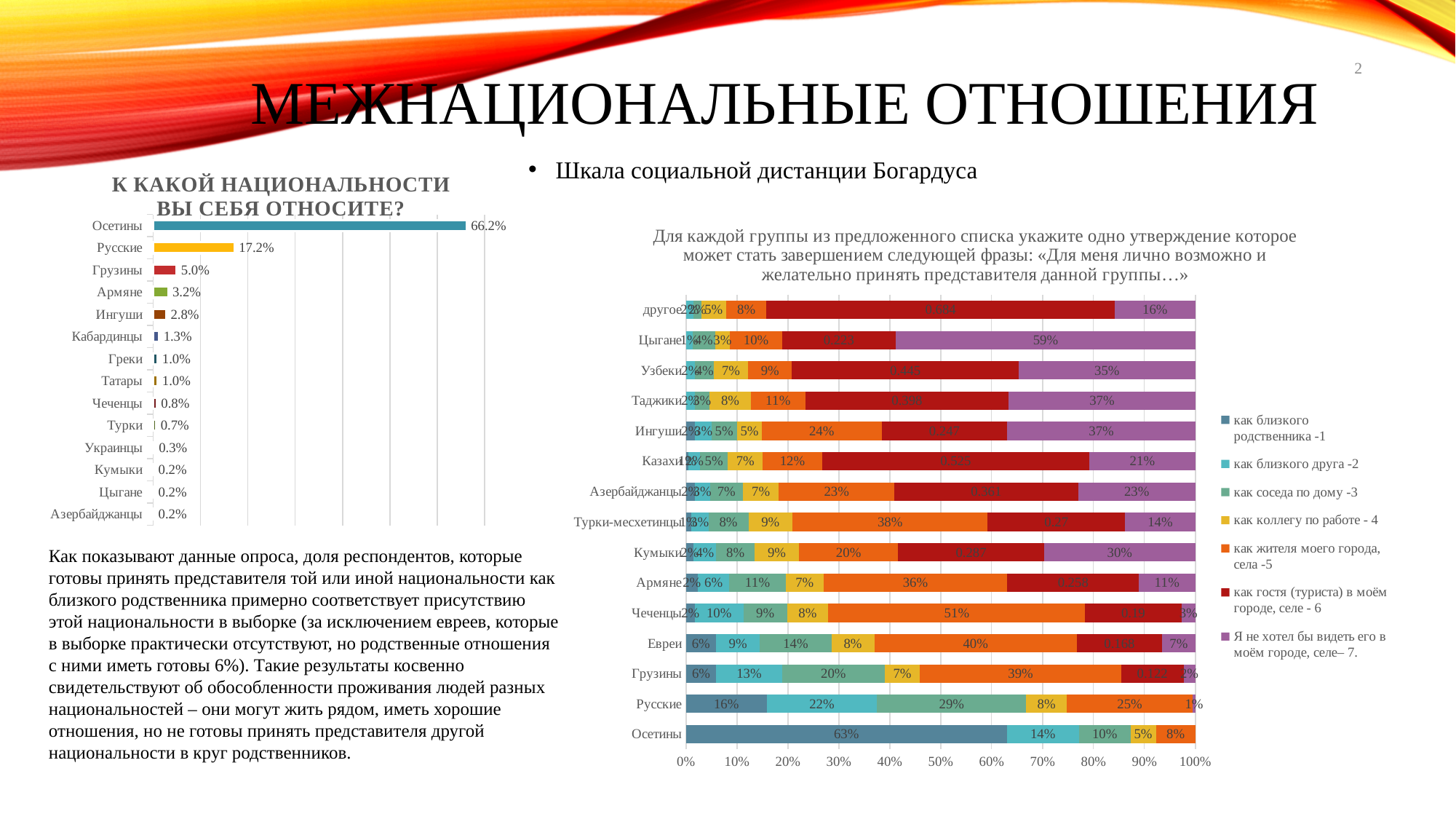
How many categories (groups) are shown in the right stacked bar chart (Шкала социальной дистанции Богардуса)? 15 In the right stacked bar chart (Шкала социальной дистанции Богардуса), what is the value for Цыгане in the series «Я не хотел бы видеть его в моём городе, селе– 7»? 59% How many series does the legend of the right stacked bar chart (Шкала социальной дистанции Богардуса) list? 7 In the left chart «К КАКОЙ НАЦИОНАЛЬНОСТИ ВЫ СЕБЯ ОТНОСИТЕ?», what is the value for Русские? 17.2% In the left chart «К КАКОЙ НАЦИОНАЛЬНОСТИ ВЫ СЕБЯ ОТНОСИТЕ?», what is the value for Ингуши? 2.8% In the left chart «К КАКОЙ НАЦИОНАЛЬНОСТИ ВЫ СЕБЯ ОТНОСИТЕ?», what is the difference between the values for Осетины and Русские? 49.0% In the right stacked bar chart (Шкала социальной дистанции Богардуса), what is the value for Осетины in the series «как близкого родственника -1»? 63% In the left chart «К КАКОЙ НАЦИОНАЛЬНОСТИ ВЫ СЕБЯ ОТНОСИТЕ?», which is larger, the value for Грузины or for Армяне? Грузины In the left chart «К КАКОЙ НАЦИОНАЛЬНОСТИ ВЫ СЕБЯ ОТНОСИТЕ?», which category has the highest value? Осетины What kind of chart is the left chart titled «К КАКОЙ НАЦИОНАЛЬНОСТИ ВЫ СЕБЯ ОТНОСИТЕ?»? bar chart In the right stacked bar chart (Шкала социальной дистанции Богардуса), what is the value for Русские in the series «как близкого друга -2»? 22% How many categories are shown in the left chart «К КАКОЙ НАЦИОНАЛЬНОСТИ ВЫ СЕБЯ ОТНОСИТЕ?»? 14